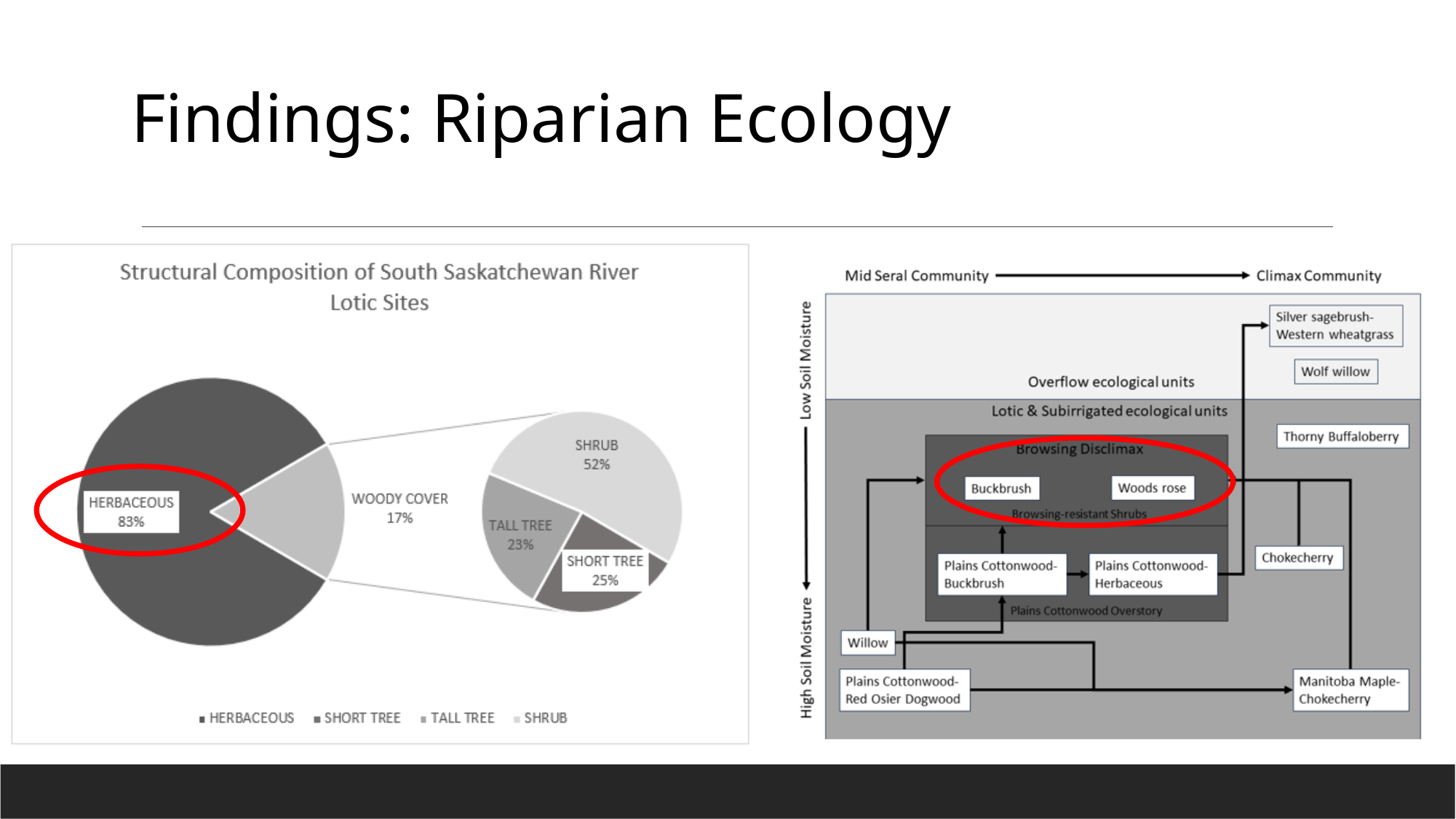
What kind of chart is the 'Structural Composition of South Saskatchewan River Lotic Sites' chart? Pie chart In the 'Structural Composition of South Saskatchewan River Lotic Sites' chart, which category in the secondary (woody cover) pie has the largest share? SHRUB In the 'Structural Composition of South Saskatchewan River Lotic Sites' chart, what percentage is labelled for WOODY COVER? 17% In the 'Structural Composition of South Saskatchewan River Lotic Sites' chart, what is the difference in percentage points between HERBACEOUS and WOODY COVER? 66 In the 'Structural Composition of South Saskatchewan River Lotic Sites' chart, what percentage is labelled for SHRUB in the secondary pie? 52% In the 'Structural Composition of South Saskatchewan River Lotic Sites' chart, what percentage is labelled for TALL TREE? 23% In the 'Structural Composition of South Saskatchewan River Lotic Sites' chart, what percentage is labelled for SHORT TREE? 25% In the 'Structural Composition of South Saskatchewan River Lotic Sites' chart, what percentage is labelled for HERBACEOUS? 83% How many entries does the legend of the 'Structural Composition of South Saskatchewan River Lotic Sites' chart list? 4 In the 'Structural Composition of South Saskatchewan River Lotic Sites' chart, which is larger, SHORT TREE or TALL TREE? SHORT TREE In the 'Structural Composition of South Saskatchewan River Lotic Sites' chart, which category in the secondary (woody cover) pie has the smallest share? TALL TREE In the 'Structural Composition of South Saskatchewan River Lotic Sites' chart, what is the difference in percentage points between SHRUB and SHORT TREE? 27